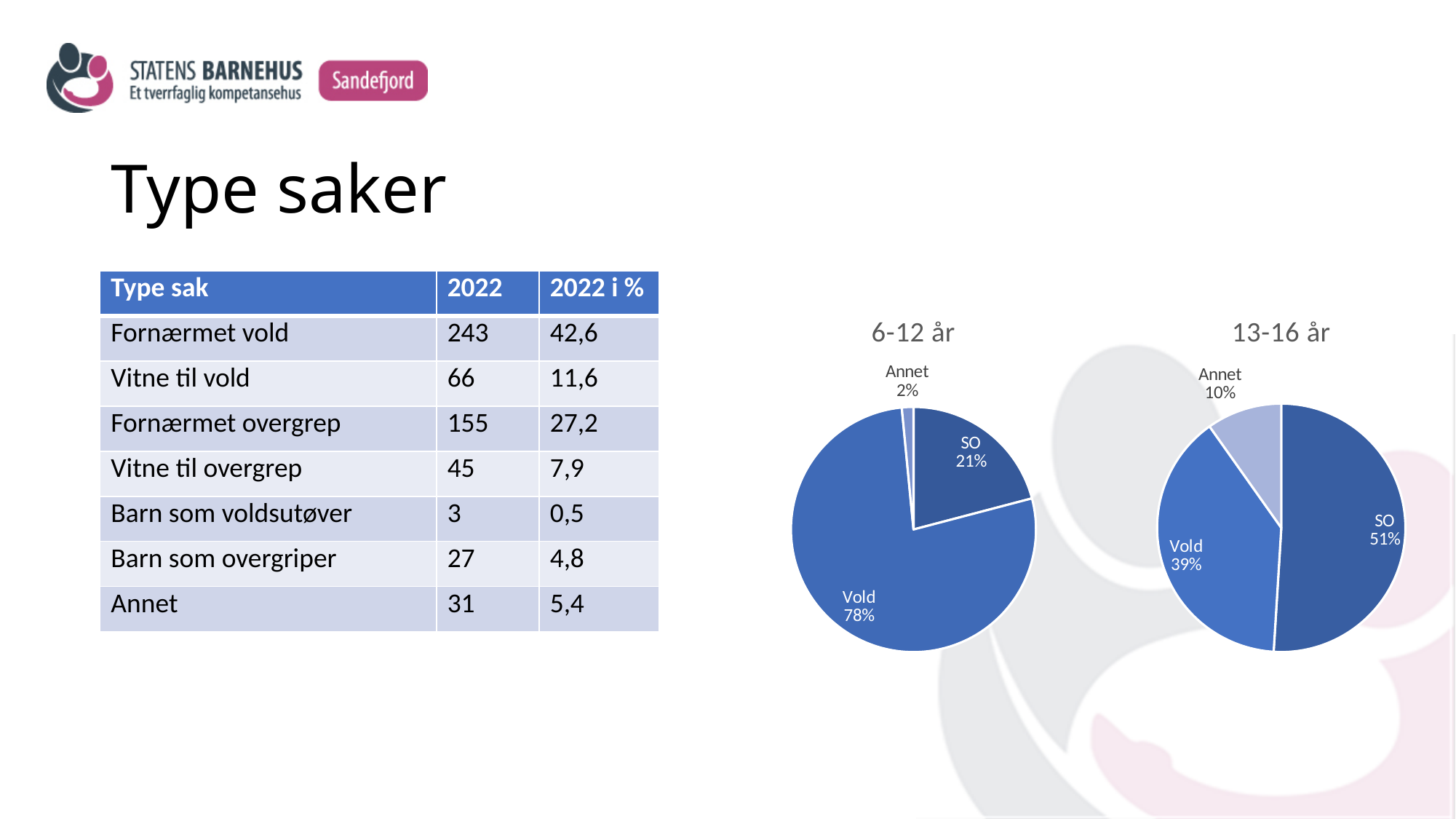
What type of chart is the '13-16 år' chart? Pie chart In the '6-12 år' pie chart, what share does SO have? 21% In the '13-16 år' pie chart, what share does Annet have? 10% In the '6-12 år' pie chart, what share does Vold have? 78% In the '13-16 år' pie chart, what is the difference in percentage points between SO and Vold? 12 In the '13-16 år' pie chart, which category has the smallest slice? Annet In the '13-16 år' pie chart, which is larger, SO or Vold? SO How many slices does the '6-12 år' pie chart have? 3 In the '6-12 år' pie chart, which category has the largest slice? Vold